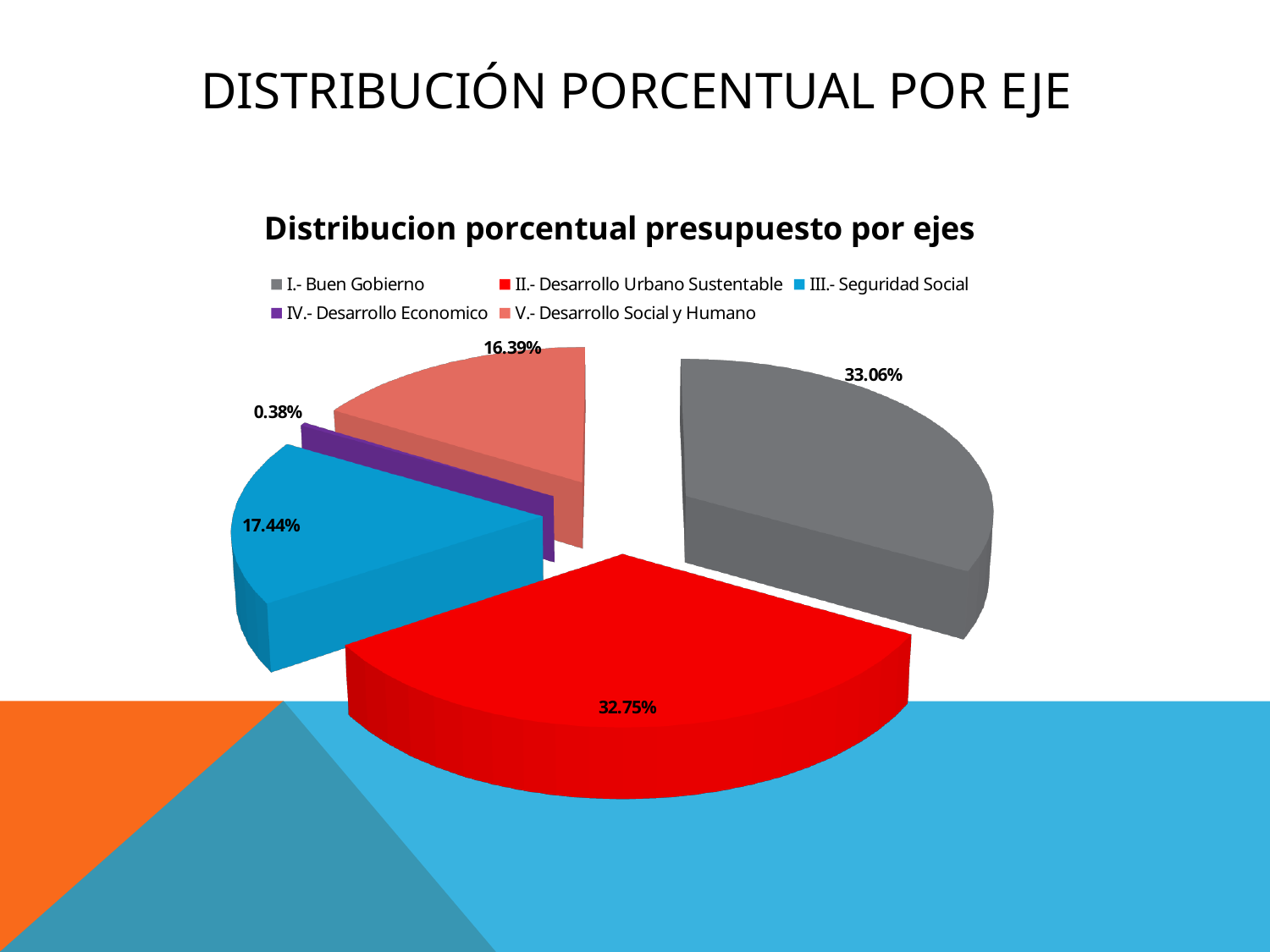
What is the value for III.- Seguridad Social? 17.44% What percentage is shown for II.- Desarrollo Urbano Sustentable? 32.75% How many slices does the pie chart have? 5 What is the difference between the shares of III.- Seguridad Social and V.- Desarrollo Social y Humano? 1.05% What is the difference between the shares of I.- Buen Gobierno and II.- Desarrollo Urbano Sustentable? 0.31% Which eje has the largest share of the budget? I.- Buen Gobierno What type of chart is shown on the slide? Pie chart What percentage is labelled for IV.- Desarrollo Economico? 0.38% Which is larger, the share for III.- Seguridad Social or for V.- Desarrollo Social y Humano? III.- Seguridad Social Which eje has the smallest share of the budget? IV.- Desarrollo Economico What is the value for V.- Desarrollo Social y Humano? 16.39% What percentage of the budget goes to I.- Buen Gobierno? 33.06%